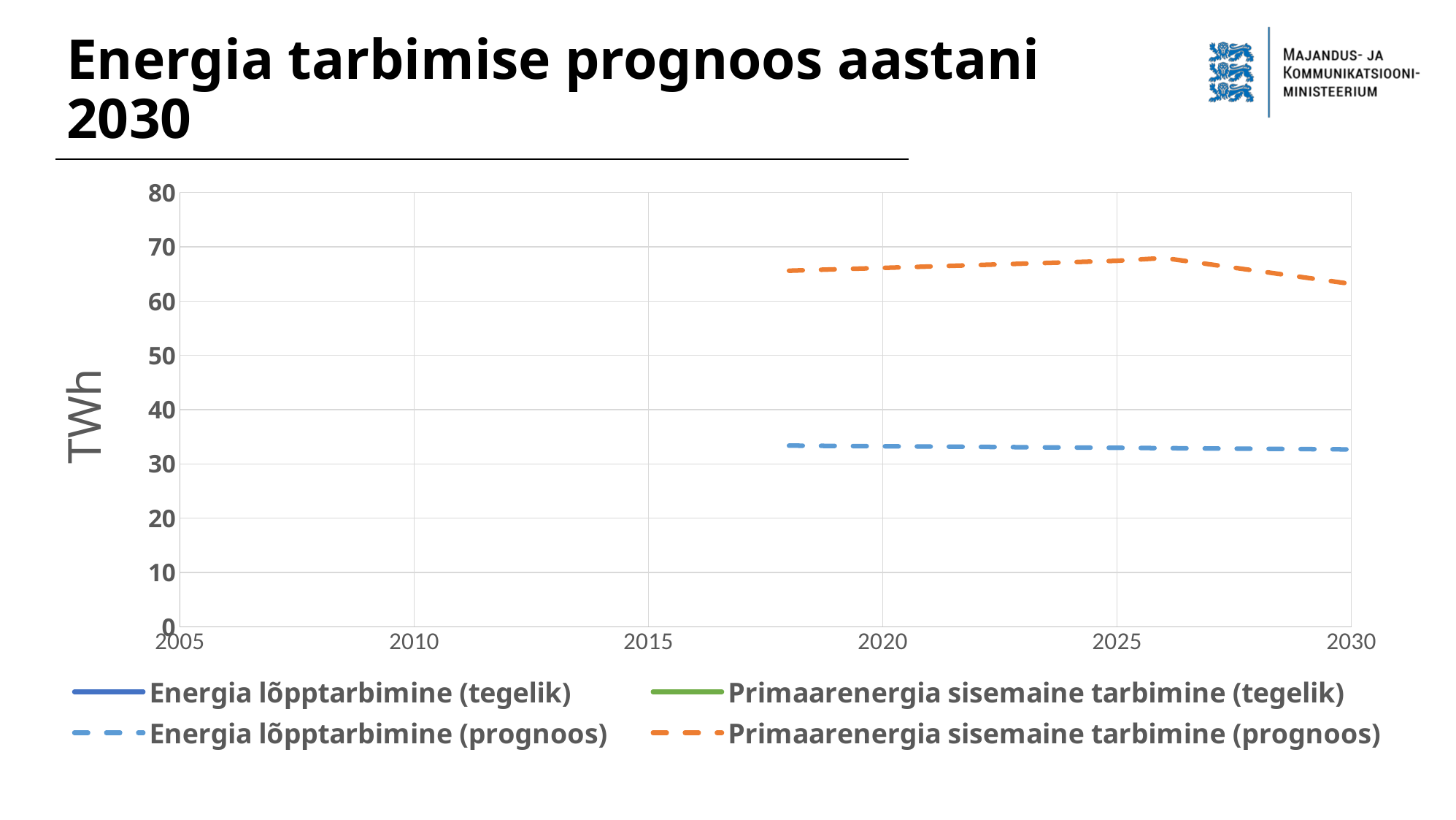
What unit is shown on the vertical axis label? TWh Is the value for Primaarenergia sisemaine tarbimine (prognoos) in 2020 greater or less than 70? less What is the title of the chart slide? Energia tarbimise prognoos aastani 2030 What kind of chart is shown on the slide? line chart Is the value for Primaarenergia sisemaine tarbimine (prognoos) in 2030 greater or less than 60? greater Is the value for Energia lõpptarbimine (prognoos) in 2018 greater or less than 30? greater Does the Energia lõpptarbimine (prognoos) line rise or fall between 2018 and 2030? fall How many series does the legend list? 4 Does the Primaarenergia sisemaine tarbimine (prognoos) line rise or fall between 2026 and 2030? fall In 2025, which series is higher: Primaarenergia sisemaine tarbimine (prognoos) or Energia lõpptarbimine (prognoos)? Primaarenergia sisemaine tarbimine (prognoos)